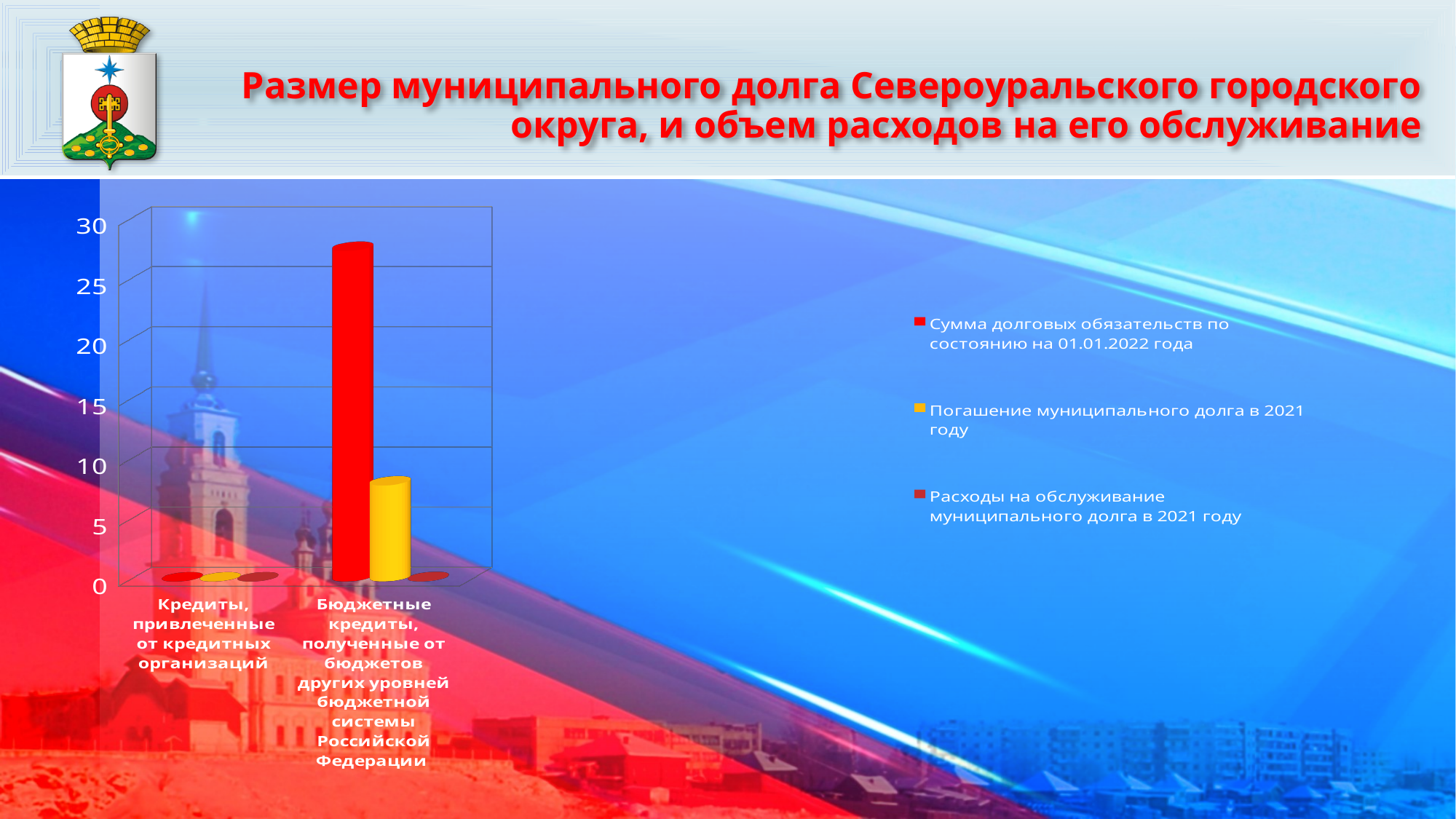
Which category has the highest value for "Сумма долговых обязательств по состоянию на 01.01.2022 года"? Бюджетные кредиты, полученные от бюджетов других уровней бюджетной системы Российской Федерации For "Бюджетные кредиты, полученные от бюджетов других уровней бюджетной системы Российской Федерации", which is larger: "Сумма долговых обязательств по состоянию на 01.01.2022 года" or "Погашение муниципального долга в 2021 году"? Сумма долговых обязательств по состоянию на 01.01.2022 года What colour represents "Погашение муниципального долга в 2021 году" in the chart? yellow Is the value of "Сумма долговых обязательств по состоянию на 01.01.2022 года" for "Бюджетные кредиты, полученные от бюджетов других уровней бюджетной системы Российской Федерации" greater or less than 25? greater Which series is the tallest bar in the chart? Сумма долговых обязательств по состоянию на 01.01.2022 года How many categories are shown on the x axis of the chart? 2 How many series does the chart legend list? 3 What is the highest value shown on the chart's vertical axis? 30 Is the value of "Погашение муниципального долга в 2021 году" for "Бюджетные кредиты, полученные от бюджетов других уровней бюджетной системы Российской Федерации" greater or less than 10? less Is the value of "Сумма долговых обязательств по состоянию на 01.01.2022 года" for "Кредиты, привлеченные от кредитных организаций" greater or less than 5? less What kind of chart is shown on the slide? bar chart